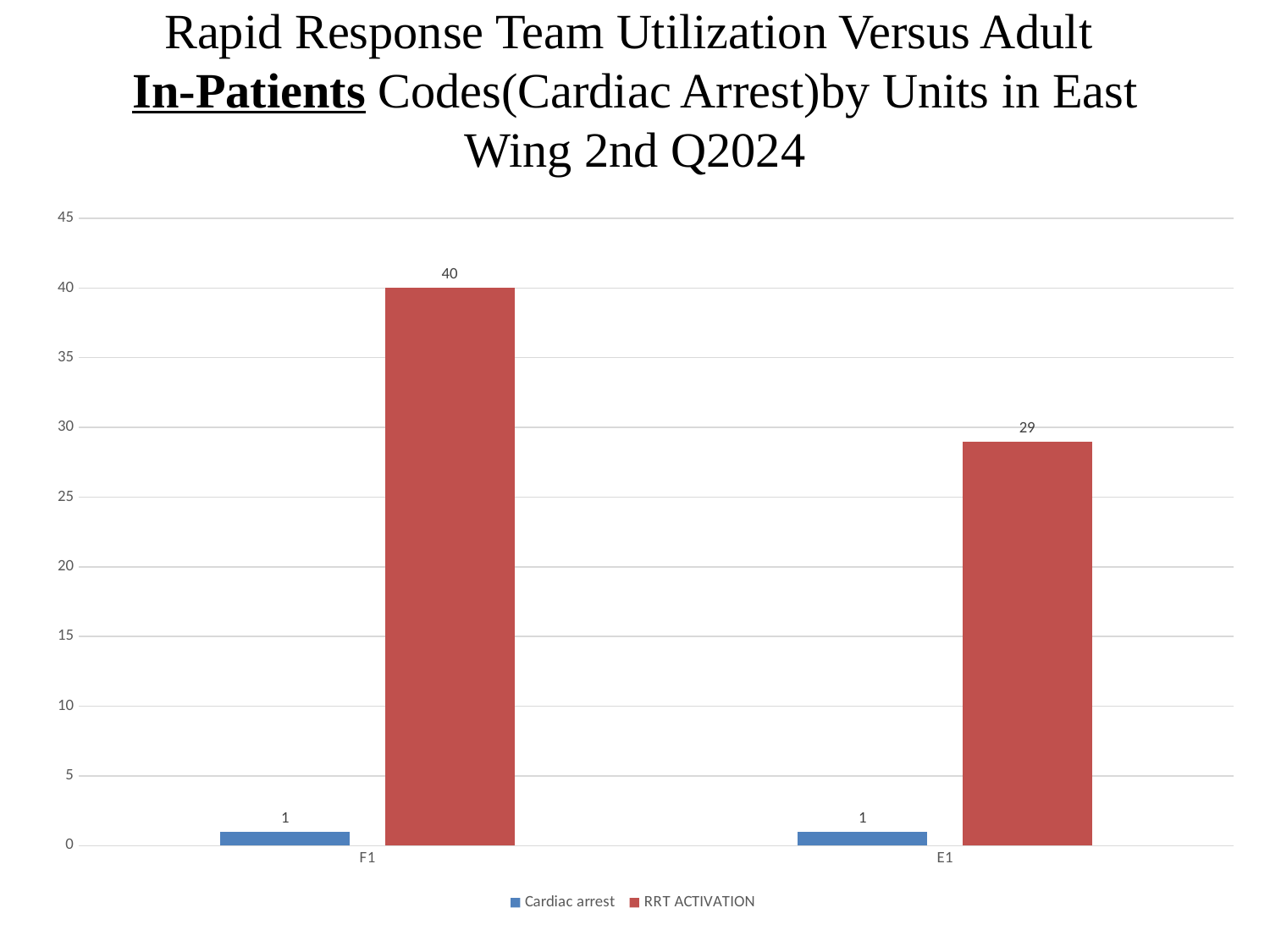
Which unit has the highest RRT ACTIVATION value? F1 What is the RRT ACTIVATION value for E1? 29 What is the RRT ACTIVATION value for F1? 40 How many units are shown on the x axis? 2 How many series does the legend list? 2 What kind of chart is shown on the slide? Bar chart Is the RRT ACTIVATION value for E1 greater or less than 30? less Which unit has the lowest RRT ACTIVATION value? E1 What is the Cardiac arrest value for F1? 1 What is the Cardiac arrest value for E1? 1 What is the difference between the RRT ACTIVATION values for F1 and E1? 11 Which is larger, the RRT ACTIVATION value for F1 or for E1? F1